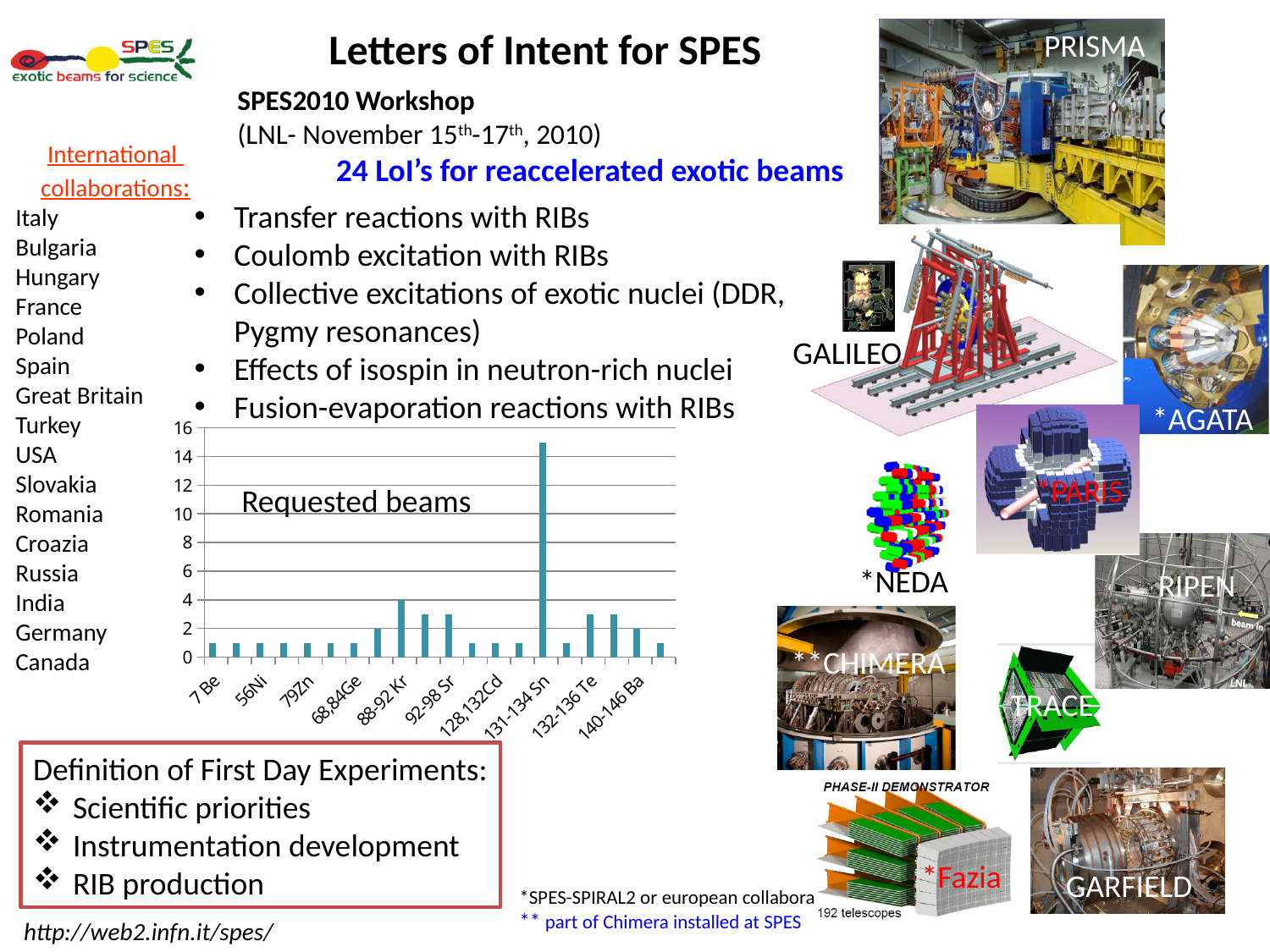
What is the title shown on the bar chart? Requested beams In the 'Requested beams' chart, is the value for 132-136 Te greater or less than 2? greater In the 'Requested beams' chart, which beam has the highest number of requests? 131-134 Sn What kind of chart is the 'Requested beams' chart? bar chart In the 'Requested beams' chart, what is the value for 88-92 Kr? 4 What is the maximum value shown on the y-axis of the 'Requested beams' chart? 16 In the 'Requested beams' chart, what is the value for 140-146 Ba? 2 In the 'Requested beams' chart, which has more requests, 131-134 Sn or 88-92 Kr? 131-134 Sn In the 'Requested beams' chart, which has more requests, 88-92 Kr or 92-98 Sr? 88-92 Kr In the 'Requested beams' chart, is the value for 7Be greater or less than 2? less In the 'Requested beams' chart, is the value for 131-134 Sn greater or less than 14? greater